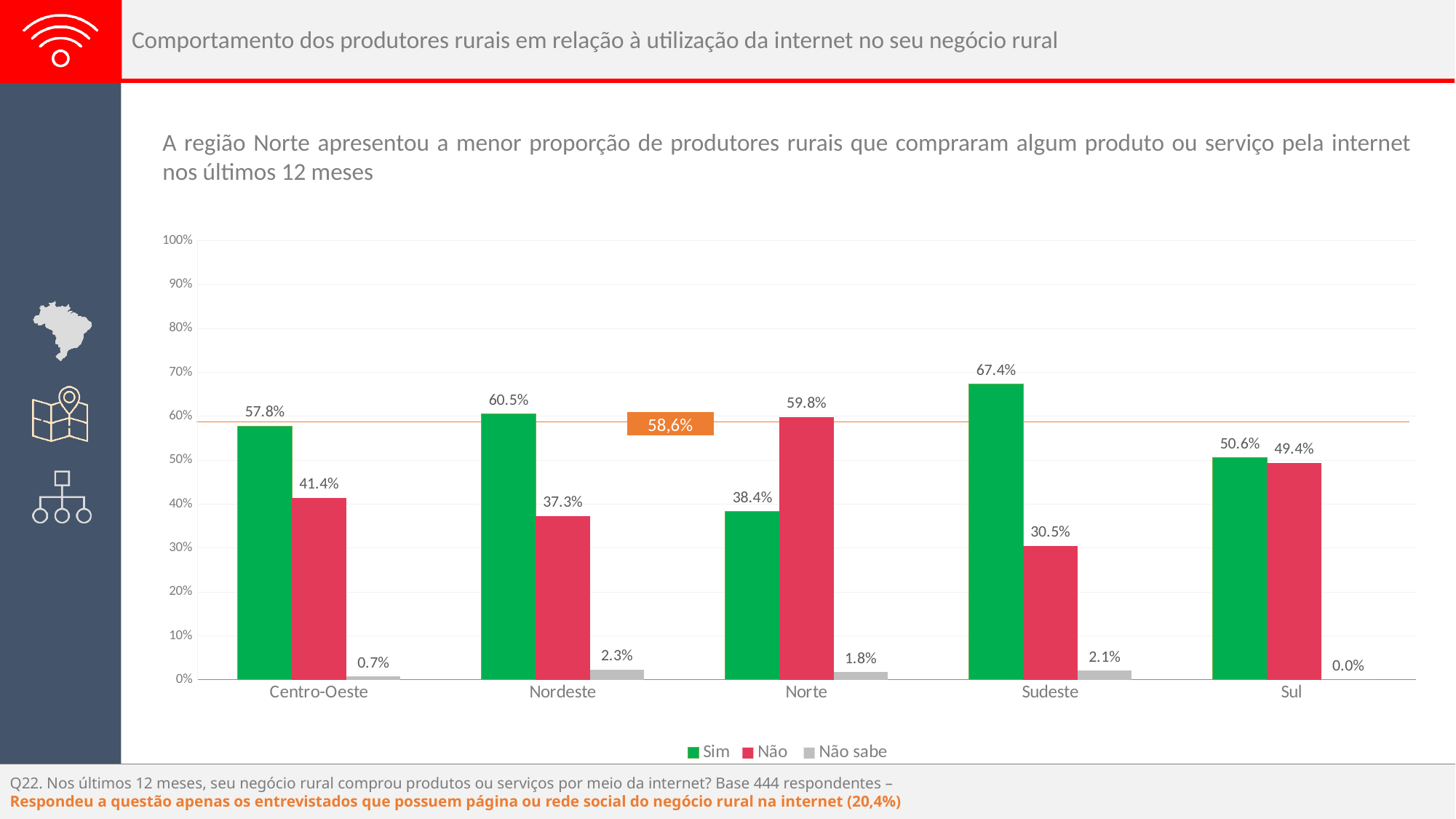
What value is shown in the orange box on the horizontal reference line? 58,6% Which is larger for Centro-Oeste, "Sim" or "Não"? Sim What is the difference between the "Sim" and "Não" values for Sul? 1.2% What is the value of "Não" for Sudeste? 30.5% How many series does the legend list? 3 Which region has the highest "Não" value? Norte How many regions are shown on the x axis? 5 Which region has the lowest "Sim" value? Norte What is the value of "Sim" for Norte? 38.4% What kind of chart is shown on the slide? Bar chart What is the value of "Não sabe" for Nordeste? 2.3% Which region has the highest "Sim" value? Sudeste